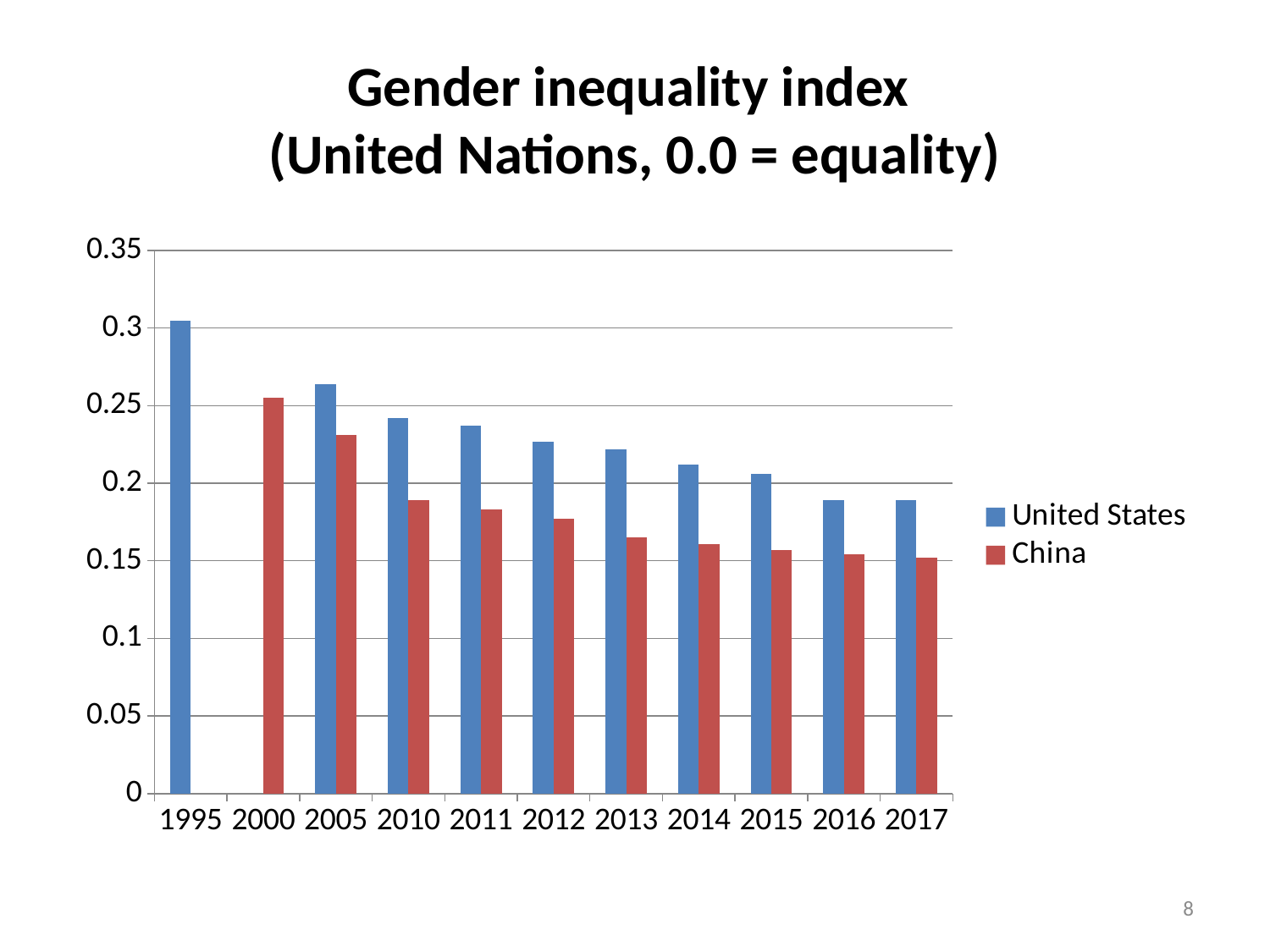
Which colour represents China in the legend? red In which year is the China bar highest? 2000 In which year is the United States bar highest? 1995 How many series does the legend list? 2 Is the value for the United States in 1995 greater or less than 0.25? greater Is the value for the United States in 2017 greater or less than 0.2? less Is the value for China in 2017 greater or less than 0.2? less What kind of chart is shown on the slide? bar chart Do the United States values rise or fall from 1995 to 2017? fall In 2010, which is larger, the value for the United States or the value for China? United States How many years are shown on the x axis? 11